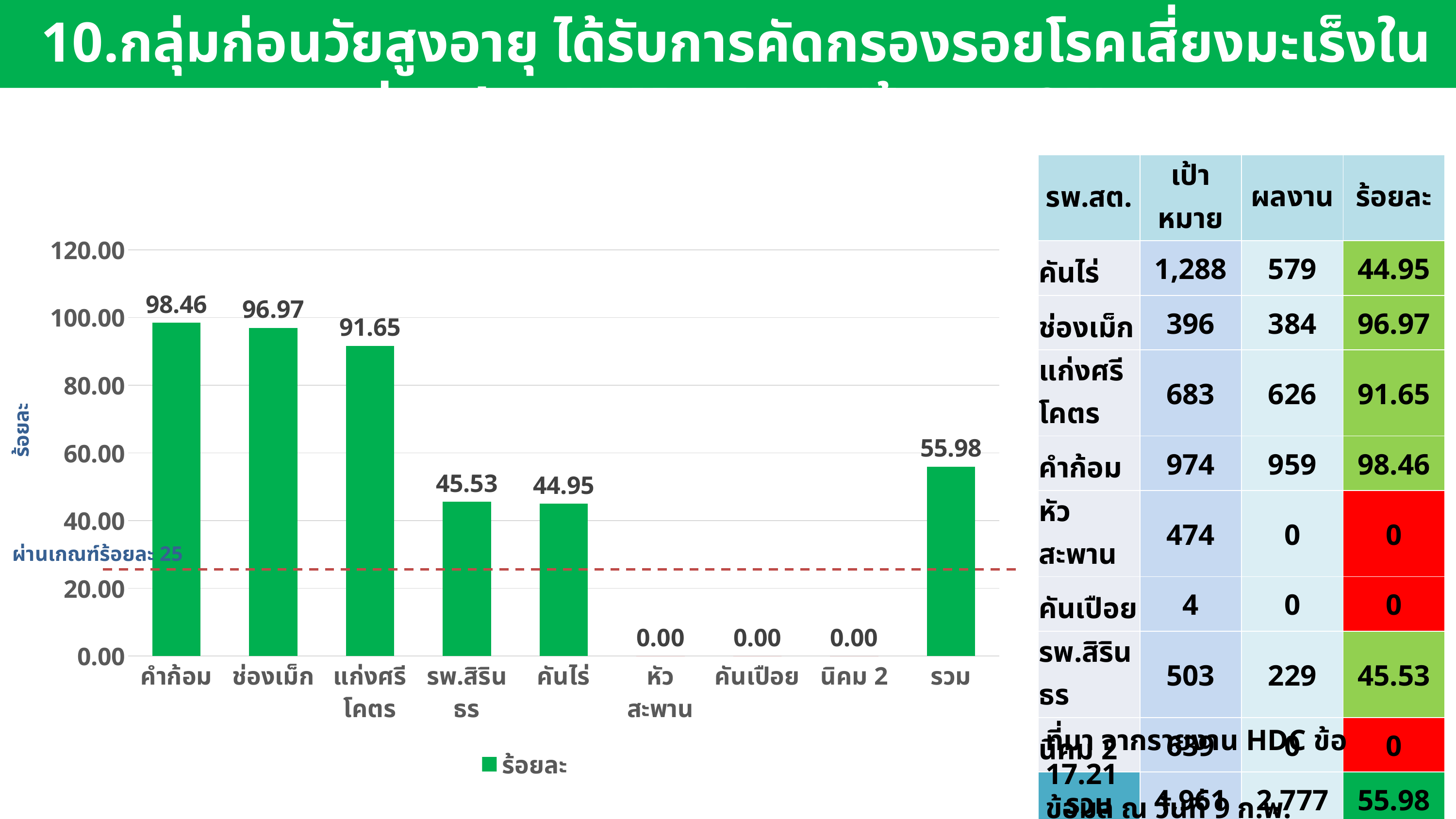
Is the value for รวม greater or less than 40.00? greater What is the difference between the values for แก่งศรีโคตร and คันไร่? 46.70 What is the value for คำก้อม? 98.46 Which category has the highest value? คำก้อม What series name does the legend show? ร้อยละ How many categories have a value of 0.00? 3 What is the difference between the values for คำก้อม and ช่องเม็ก? 1.49 Which is larger, the value for รพ.สิรินธร or the value for คันไร่? รพ.สิรินธร What is the value for รวม? 55.98 What is the value for รพ.สิรินธร? 45.53 What kind of chart is shown? bar chart How many categories are shown on the x axis? 9